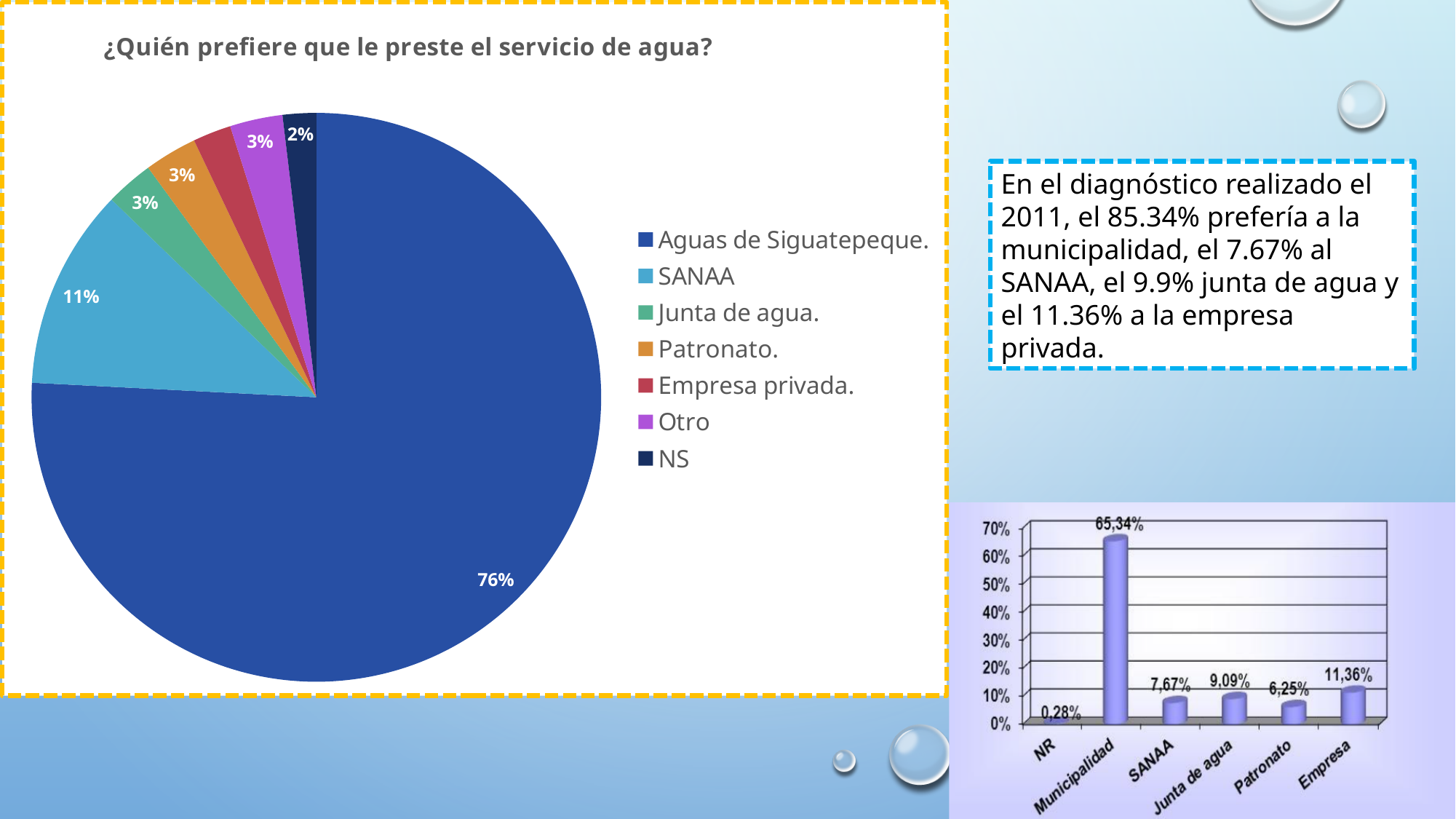
In the pie chart titled '¿Quién prefiere que le preste el servicio de agua?', what percentage is shown for NS? 2% In the pie chart titled '¿Quién prefiere que le preste el servicio de agua?', what is the difference in percentage points between Aguas de Siguatepeque and SANAA? 65 In the bar chart at the bottom right of the slide, what value is shown for Municipalidad? 65,34% In the bar chart at the bottom right of the slide, what value is shown for Empresa? 11,36% What kind of chart is the one at the bottom right of the slide? Bar chart In the bar chart at the bottom right of the slide, which is larger, SANAA or Junta de agua? Junta de agua In the pie chart titled '¿Quién prefiere que le preste el servicio de agua?', what share does Aguas de Siguatepeque have? 76% In the pie chart titled '¿Quién prefiere que le preste el servicio de agua?', how many categories does the legend list? 7 In the pie chart titled '¿Quién prefiere que le preste el servicio de agua?', which category has the smallest slice? NS In the pie chart titled '¿Quién prefiere que le preste el servicio de agua?', which category has the largest slice? Aguas de Siguatepeque. In the bar chart at the bottom right of the slide, which category has the lowest value? NR In the pie chart titled '¿Quién prefiere que le preste el servicio de agua?', what percentage is shown for SANAA? 11%